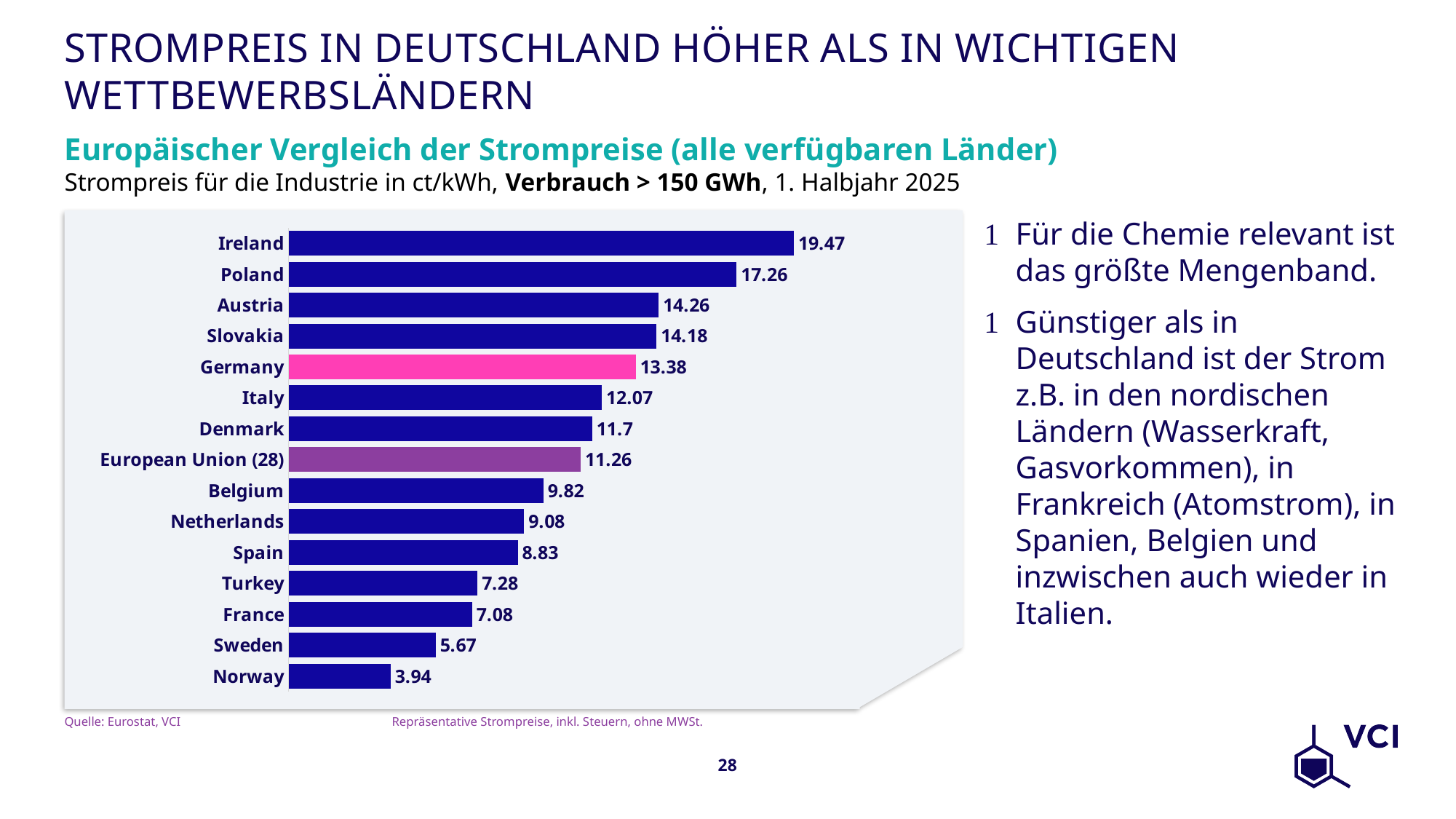
Which country has the highest electricity price? Ireland What is the electricity price for France? 7.08 What is the difference between the electricity price for Germany and for European Union (28)? 2.12 What is the difference between the electricity price for Ireland and for Poland? 2.21 Which has a higher electricity price, Sweden or Norway? Sweden What is the electricity price for European Union (28)? 11.26 What is the electricity price for Germany? 13.38 Which bar is highlighted in pink? Germany What kind of chart is shown on the slide? Bar chart Which country has the lowest electricity price? Norway How many countries or regions are shown in the chart? 15 Which has a higher electricity price, Austria or Slovakia? Austria